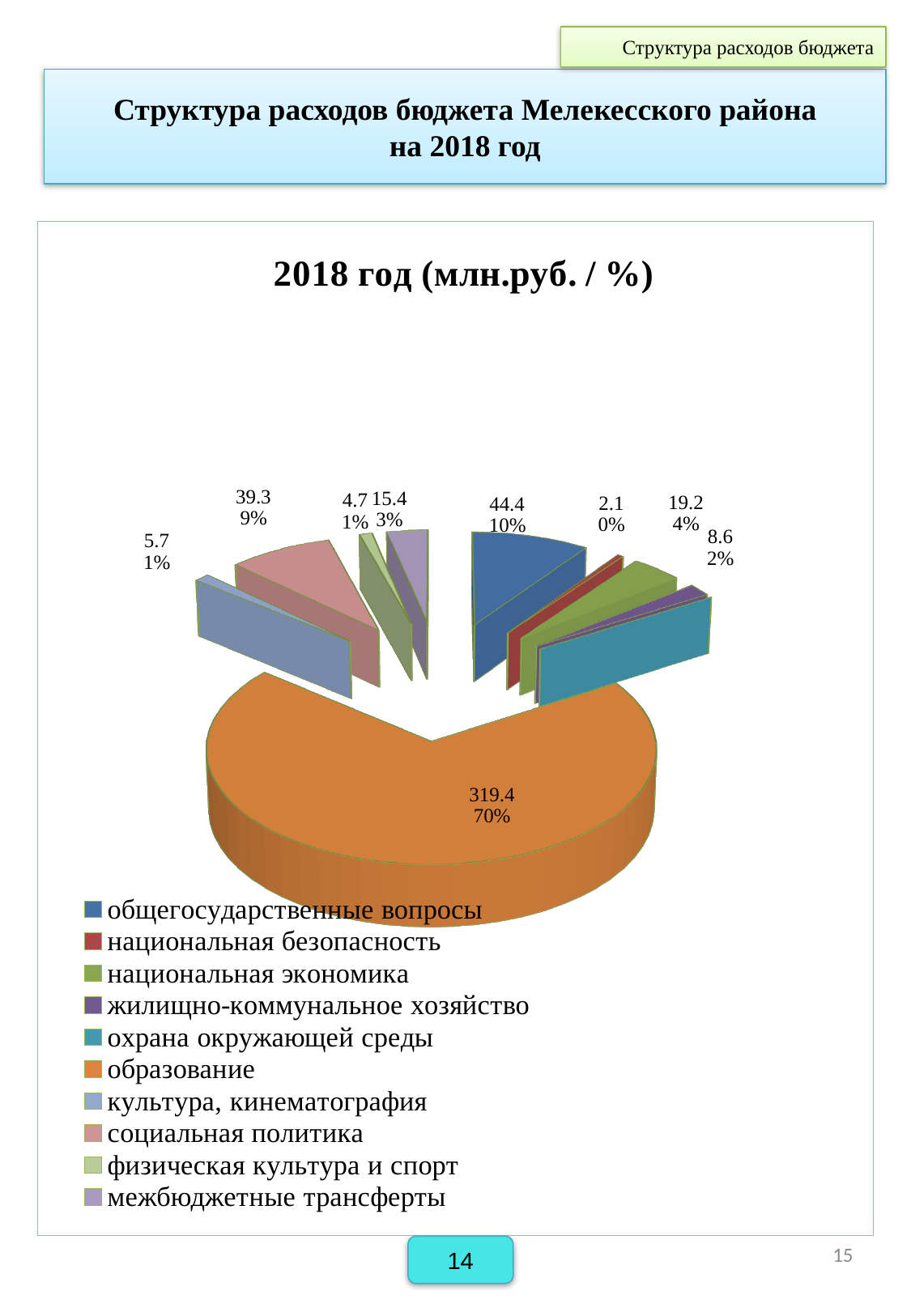
What is the difference between the values for общегосударственные вопросы and социальная политика? 5.1 What is the title of the chart? 2018 год (млн.руб. / %) What share of the pie does национальная экономика account for? 4% Which is larger, the value for социальная политика or the value for национальная экономика? социальная политика What value in млн.руб. is shown for образование? 319.4 What kind of chart is shown on the slide? pie chart What value is shown for межбюджетные трансферты? 15.4 What value is shown for общегосударственные вопросы? 44.4 What share of the pie does образование account for? 70% How many categories does the legend of the pie chart list? 10 Which category has the largest slice of the pie? образование What value is shown for социальная политика? 39.3